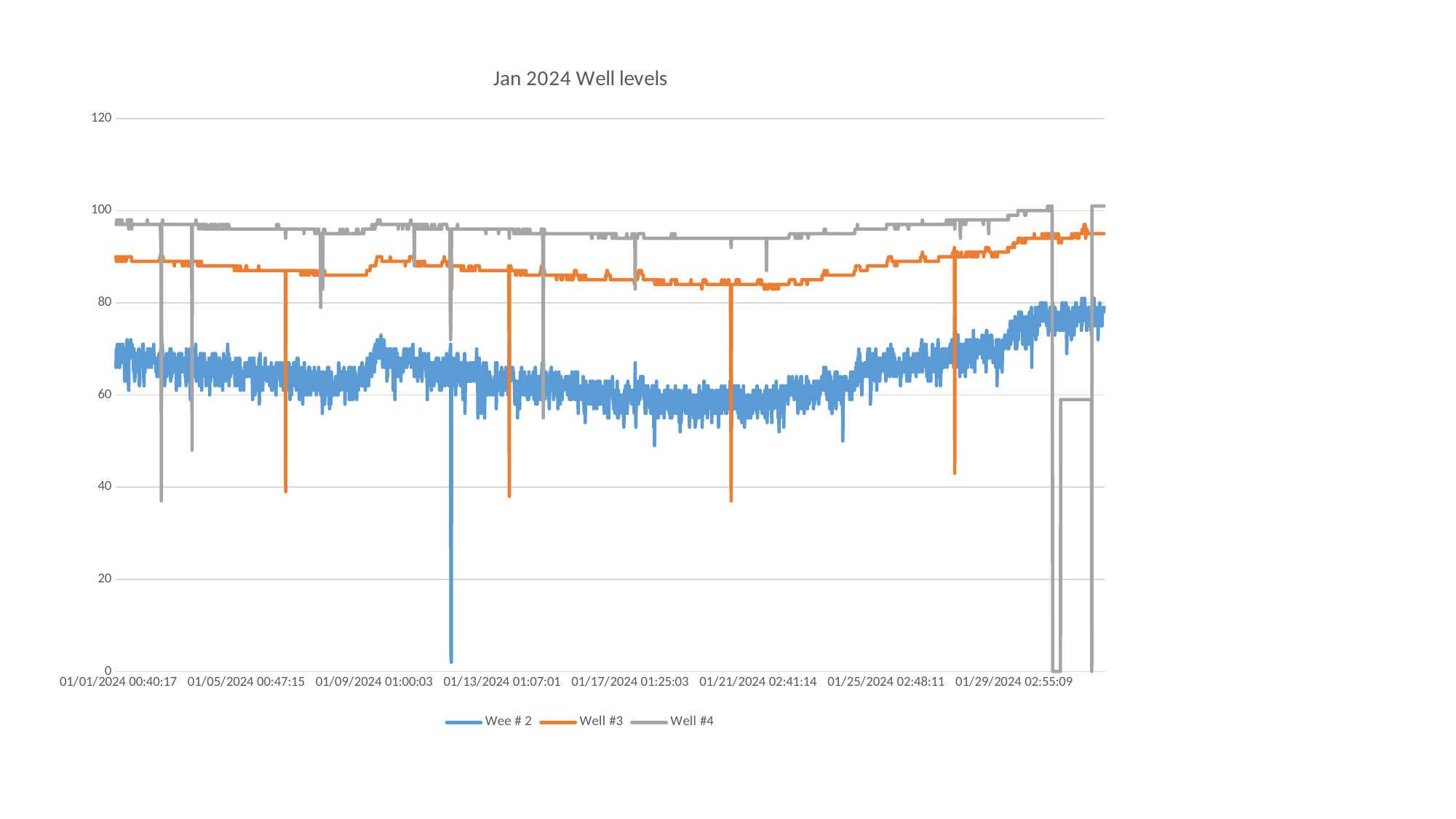
Around 01/17/2024, which series is higher, Well #3 or Wee # 2? Well #3 Which series has the highest level for most of the period? Well #4 Does the Wee # 2 level rise or fall between 01/21/2024 and the end of the month? rise Which series is plotted in orange according to the legend? Well #3 What kind of chart is shown on the slide? line chart Is the value for Wee # 2 at the start of the period (01/01/2024) greater or less than 80? less Which series has the lowest level for most of the period? Wee # 2 How many series does the legend list? 3 Is the value for Well #4 at the start of the period (01/01/2024) greater or less than 80? greater How many date labels are shown on the x axis? 8 Is the value for Well #3 around 01/21/2024 greater or less than 100? less What is the title of the chart? Jan 2024 Well levels